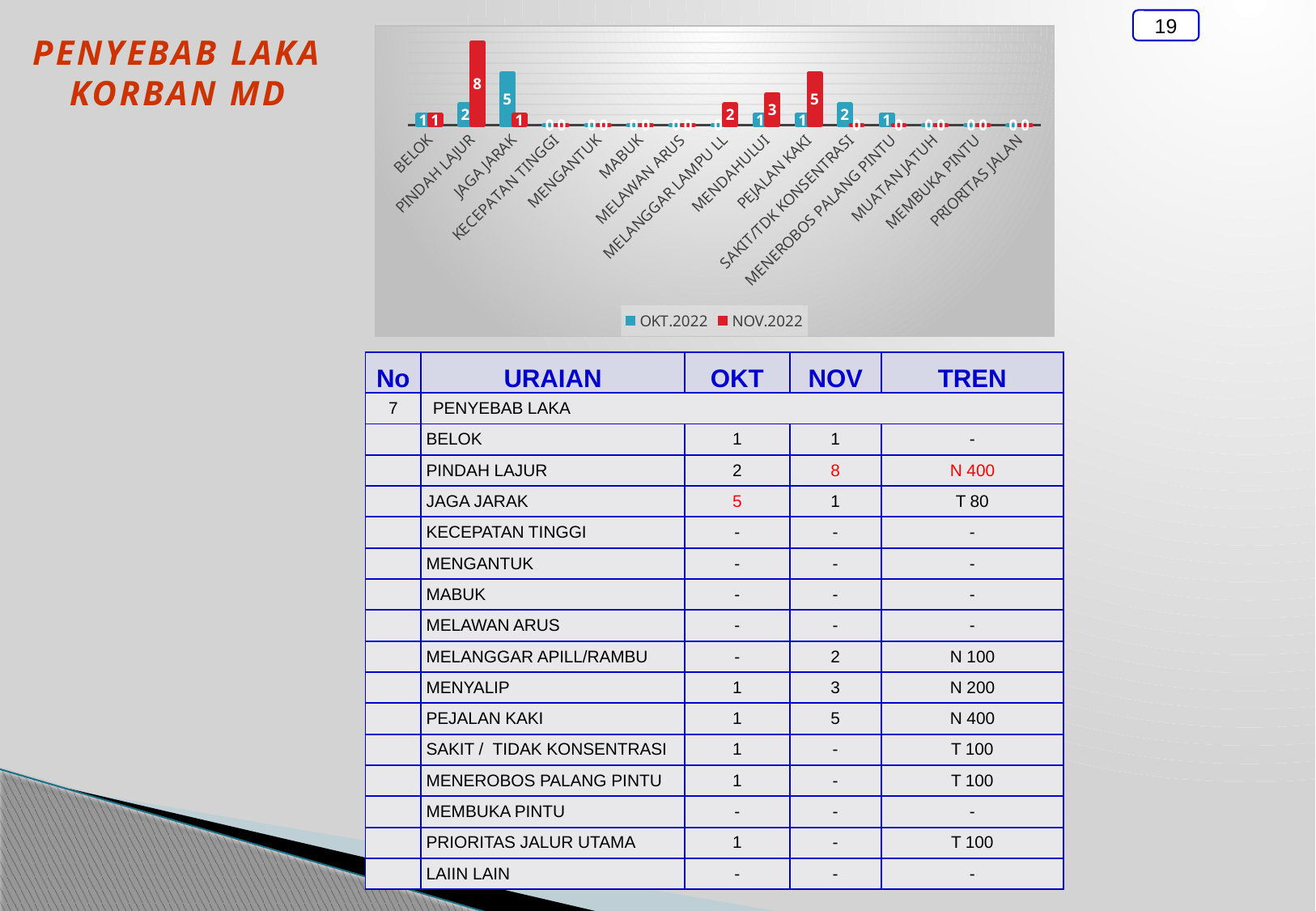
What is the NOV.2022 value for MENDAHULUI? 3 What is the difference between the NOV.2022 and OKT.2022 values for PINDAH LAJUR? 6 For PEJALAN KAKI, which is larger: the OKT.2022 value or the NOV.2022 value? NOV.2022 How many series does the chart legend list? 2 What is the NOV.2022 value for PEJALAN KAKI? 5 Which category has the highest OKT.2022 value? JAGA JARAK How many categories are shown on the x axis of the chart? 15 Which category has the highest NOV.2022 value? PINDAH LAJUR For JAGA JARAK, which is larger: the OKT.2022 value or the NOV.2022 value? OKT.2022 What is the OKT.2022 value for JAGA JARAK? 5 What is the NOV.2022 value for PINDAH LAJUR? 8 What kind of chart is shown on the slide? Bar chart